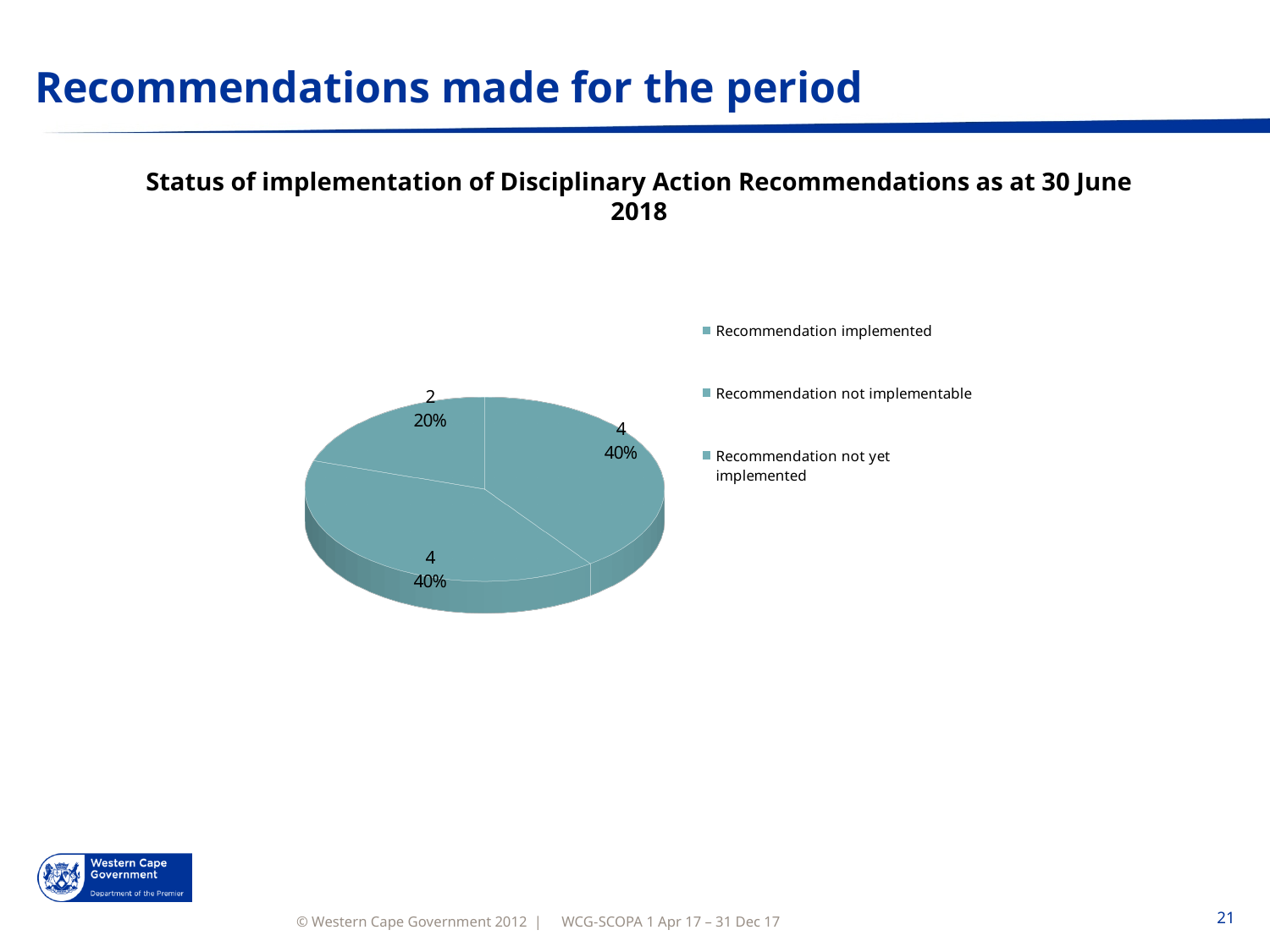
What count is shown on the smallest slice of the pie? 2 What is the third entry listed in the legend? Recommendation not yet implemented How many slices does the pie chart have? 3 What is the total of the counts shown on all slices of the pie? 10 What is the largest percentage shown on any slice of the pie? 40% How many entries does the legend list? 3 What is the difference in count between a slice labelled 4 and the slice labelled 2? 2 What is the title of the chart? Status of implementation of Disciplinary Action Recommendations as at 30 June 2018 What percentage is shown on the smallest slice of the pie? 20% How many slices are labelled 40%? 2 What is the difference in percentage points between a 40% slice and the 20% slice? 20% What kind of chart is shown on the slide? pie chart